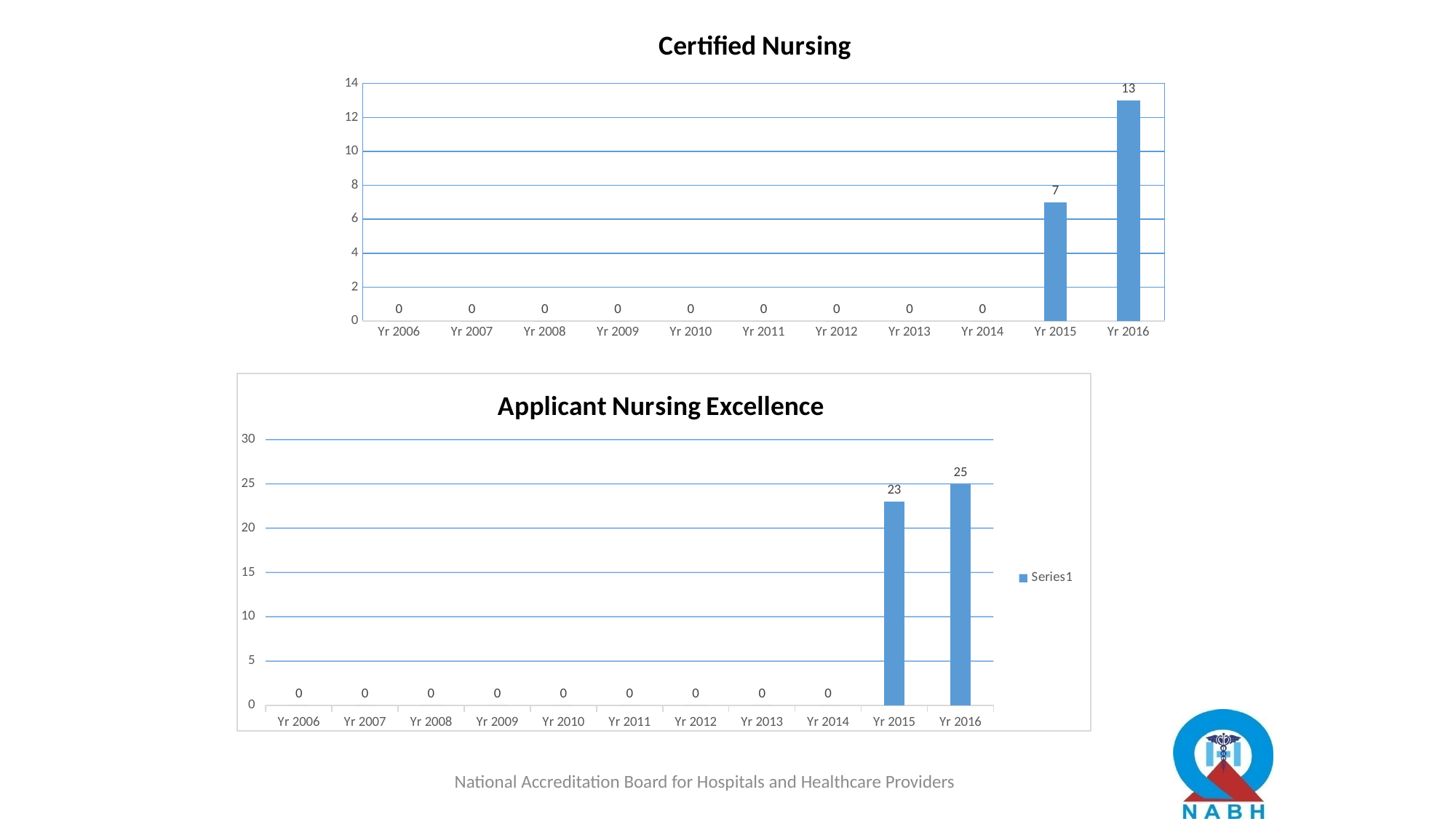
In the 'Applicant Nursing Excellence' chart, what is the value for Yr 2015? 23 In the 'Certified Nursing' chart, which year has the highest value? Yr 2016 What kind of chart is the 'Applicant Nursing Excellence' chart? Bar chart In the 'Certified Nursing' chart, what is the value for Yr 2016? 13 In the 'Applicant Nursing Excellence' chart, what series name does the legend show? Series1 In the 'Applicant Nursing Excellence' chart, what is the difference between the values for Yr 2016 and Yr 2015? 2 In the 'Certified Nursing' chart, what is the value for Yr 2015? 7 In the 'Certified Nursing' chart, what is the difference between the values for Yr 2016 and Yr 2015? 6 In the 'Applicant Nursing Excellence' chart, what is the value for Yr 2016? 25 In the 'Certified Nursing' chart, how many years are shown on the x axis? 11 In the 'Applicant Nursing Excellence' chart, what is the value for Yr 2010? 0 In the 'Applicant Nursing Excellence' chart, which is larger, the value for Yr 2015 or Yr 2016? Yr 2016